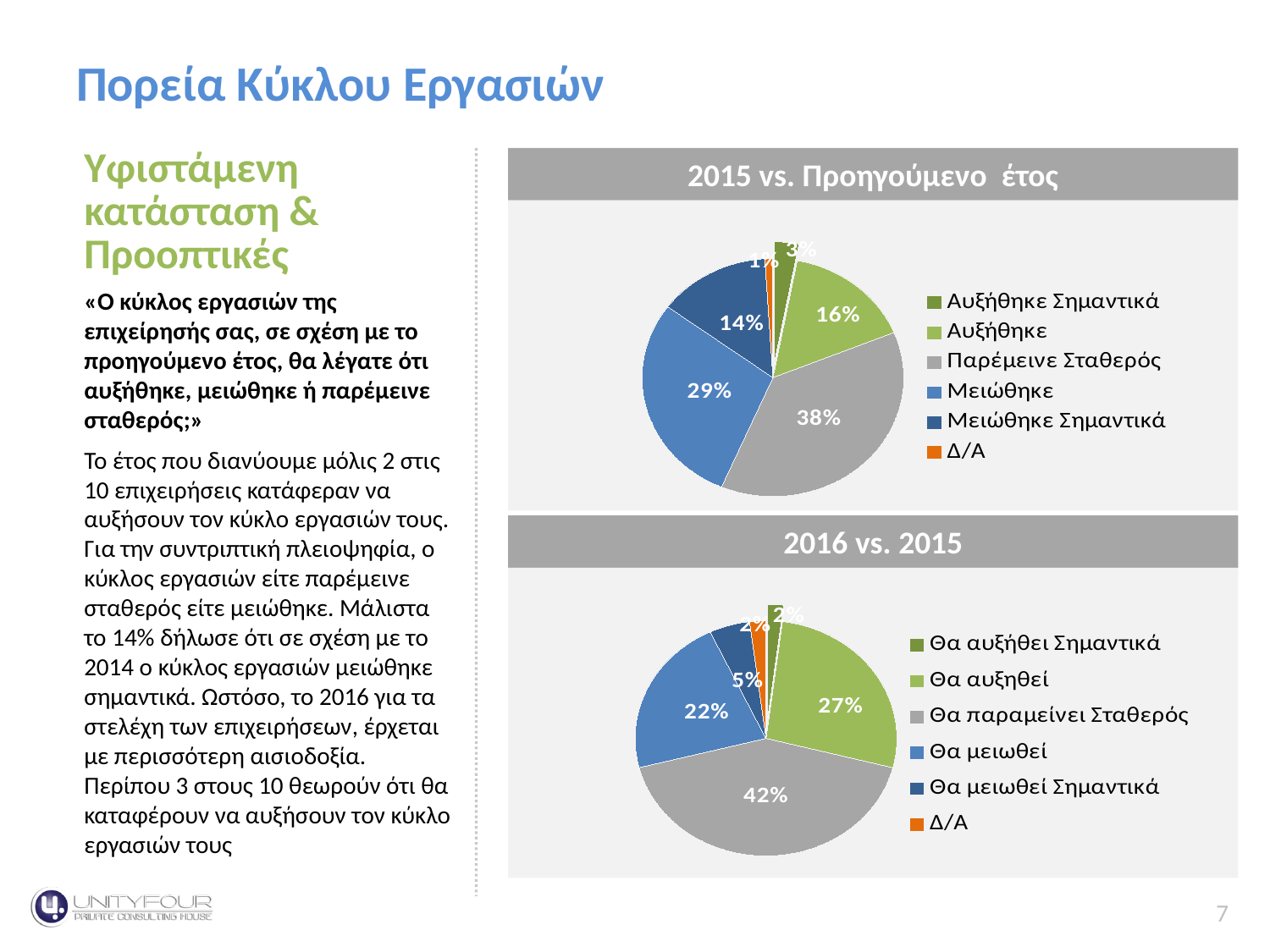
In the '2015 vs. Προηγούμενο έτος' chart, what share is 'Παρέμεινε Σταθερός'? 38% In the '2016 vs. 2015' chart, what share is 'Θα παραμείνει Σταθερός'? 42% What colour is the 'Θα παραμείνει Σταθερός' slice in the '2016 vs. 2015' chart? Grey In the '2016 vs. 2015' chart, which is larger: 'Θα αυξηθεί' or 'Θα μειωθεί'? Θα αυξηθεί In the '2016 vs. 2015' chart, what is the difference between 'Θα παραμείνει Σταθερός' and 'Θα αυξηθεί'? 15 percentage points In the '2015 vs. Προηγούμενο έτος' chart, which category has the largest slice? Παρέμεινε Σταθερός In the '2015 vs. Προηγούμενο έτος' chart, which category has the smallest slice? Δ/Α In the '2016 vs. 2015' chart, what share is 'Θα μειωθεί'? 22% What kind of chart is the '2015 vs. Προηγούμενο έτος' chart? Pie chart How many categories does the legend of the '2015 vs. Προηγούμενο έτος' chart list? 6 In the '2015 vs. Προηγούμενο έτος' chart, what share is 'Μειώθηκε Σημαντικά'? 14% In the '2015 vs. Προηγούμενο έτος' chart, what is the difference between 'Μειώθηκε' and 'Αυξήθηκε'? 13 percentage points